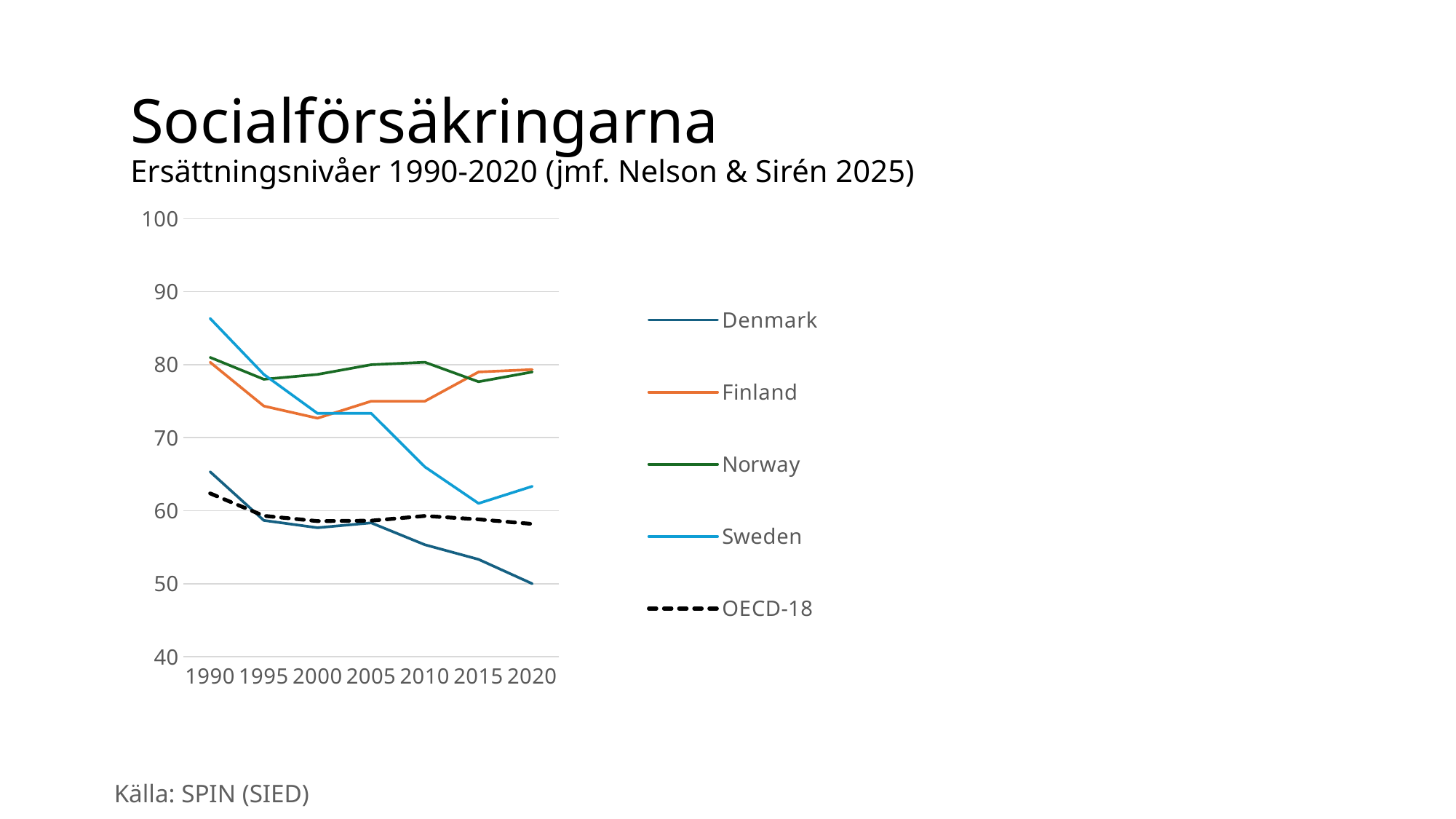
Is the value for Finland in 2000 greater or less than 80? less Which series is drawn with a dashed line? OECD-18 Which series has the lowest value in 2020? Denmark How many years are marked on the x axis? 7 In 2020, which is larger: the value for Sweden or the value for Denmark? Sweden Does the Sweden line rise or fall from 1990 to 2015? fall Which series has the highest value in 1990? Sweden Is the value for Sweden in 2015 greater or less than 70? less How many series does the legend list? 5 What kind of chart is shown on the slide? line chart Does the Denmark line rise or fall from 1990 to 2020? fall Is the value for Denmark in 1990 greater or less than 60? greater